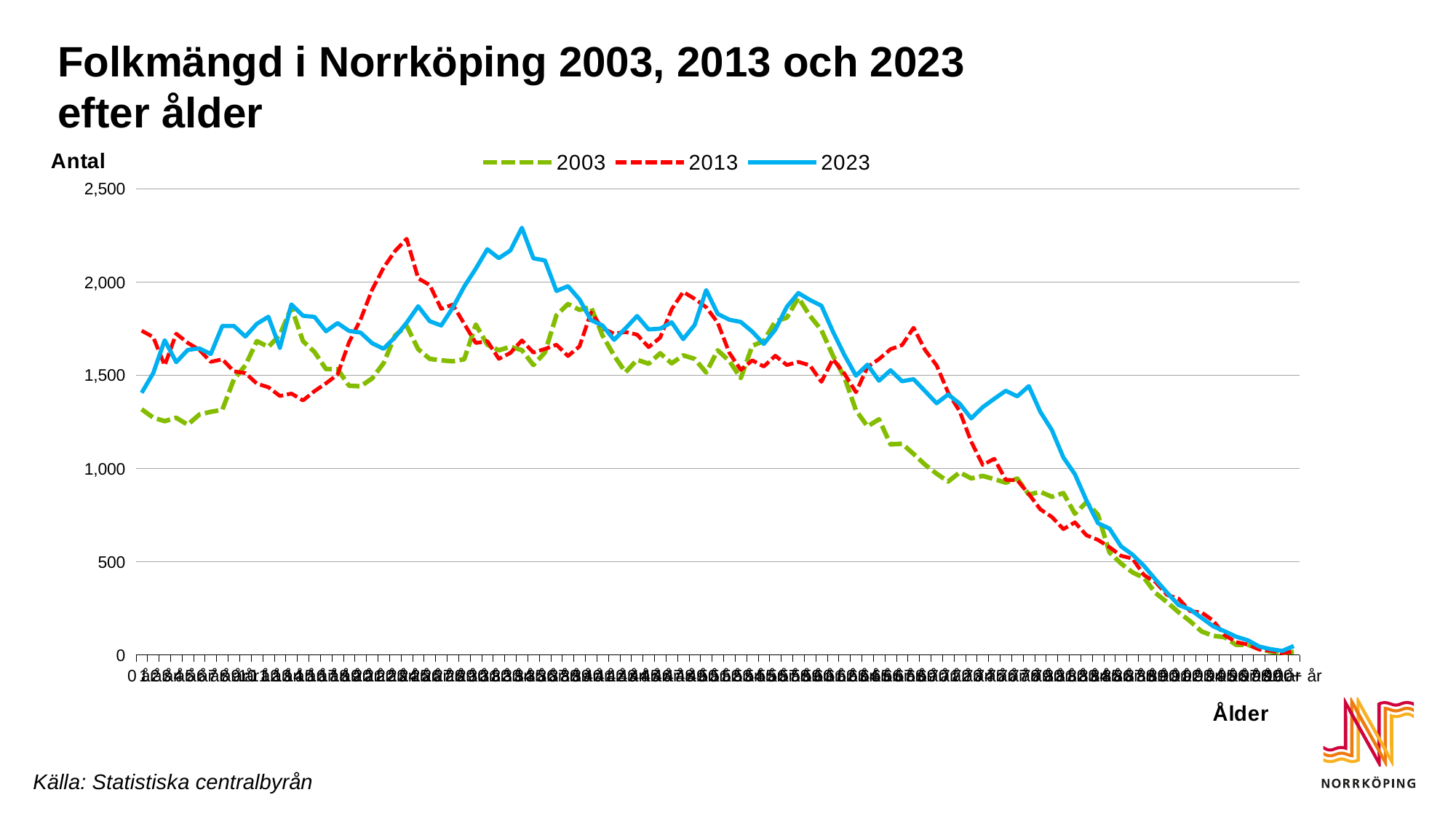
Is the highest point of the 2013 line greater or less than 2,000? greater What kind of chart is shown on the slide? line chart Is the value at the far left (age 0) of the 2023 line greater or less than 1,000? greater What is the title of the chart? Folkmängd i Norrköping 2003, 2013 och 2023 efter ålder Which series has the lowest peak value on the chart? 2003 Is the value at the far right end of the 2023 line greater or less than 500? less How many series does the legend list? 3 Which years are listed in the chart legend? 2003, 2013 and 2023 Which series reaches the highest value anywhere on the chart? 2023 Do the values of all three lines rise or fall toward the right-hand end of the x axis? fall